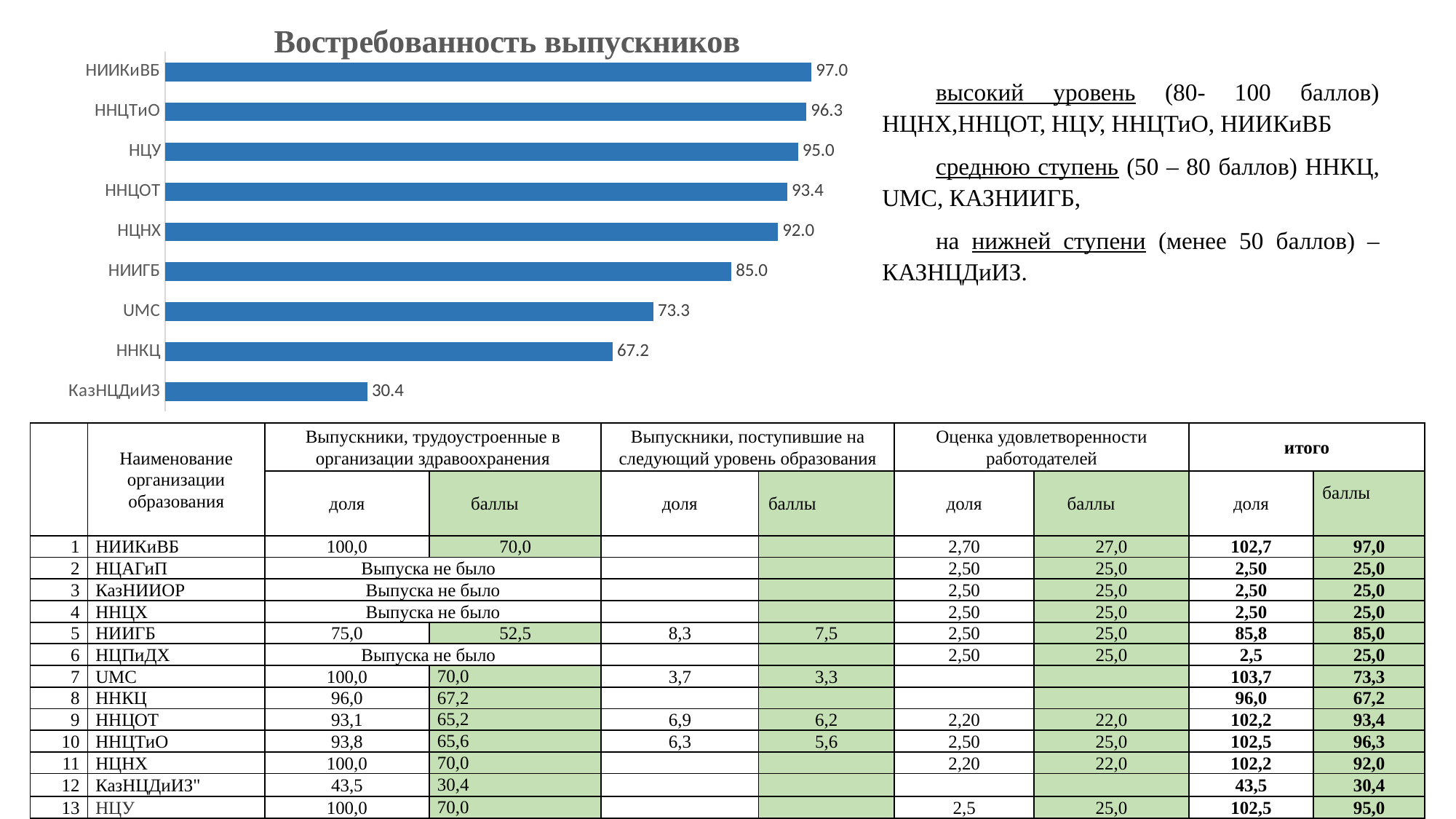
What is the value for НЦНХ in the chart? 92.0 Which organisation has the lowest value in the chart? КазНЦДиИЗ Which has a larger value, ННКЦ or UMC? UMC What is the difference between the values for НИИГБ and UMC? 11.7 What is the value for КазНЦДиИЗ in the chart? 30.4 What is the title of the chart? Востребованность выпускников How many organisations are shown in the chart? 9 What is the difference between the values for НИИКиВБ and КазНЦДиИЗ? 66.6 What is the value for НИИКиВБ in the chart? 97.0 What is the value for UMC in the chart? 73.3 What type of chart is shown on the slide? Bar chart Which organisation has the highest value in the chart? НИИКиВБ